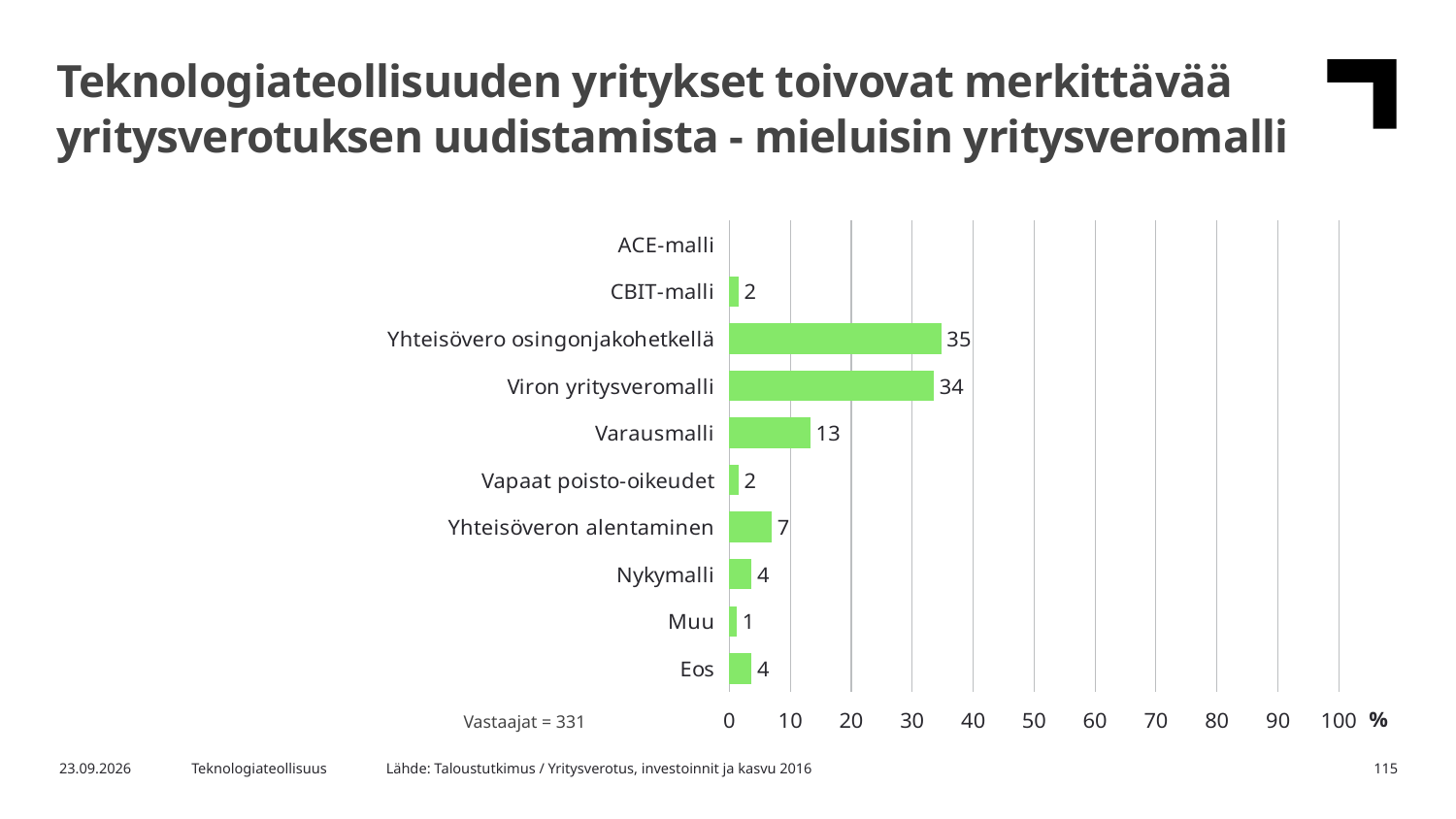
What is the value for Nykymalli? 4 Which is larger, the value for Varausmalli or the value for Nykymalli? Varausmalli What is the value for Yhteisöveron alentaminen? 7 What is the difference between the values for Yhteisövero osingonjakohetkellä and Viron yritysveromalli? 1 What is the difference between the values for Varausmalli and Yhteisöveron alentaminen? 6 How many categories are shown on the chart? 10 What is the value for Muu? 1 What is the value for Viron yritysveromalli? 34 Which category has the highest value? Yhteisövero osingonjakohetkellä What kind of chart is shown on the slide? Bar chart What is the value for Yhteisövero osingonjakohetkellä? 35 What is the value for Varausmalli? 13